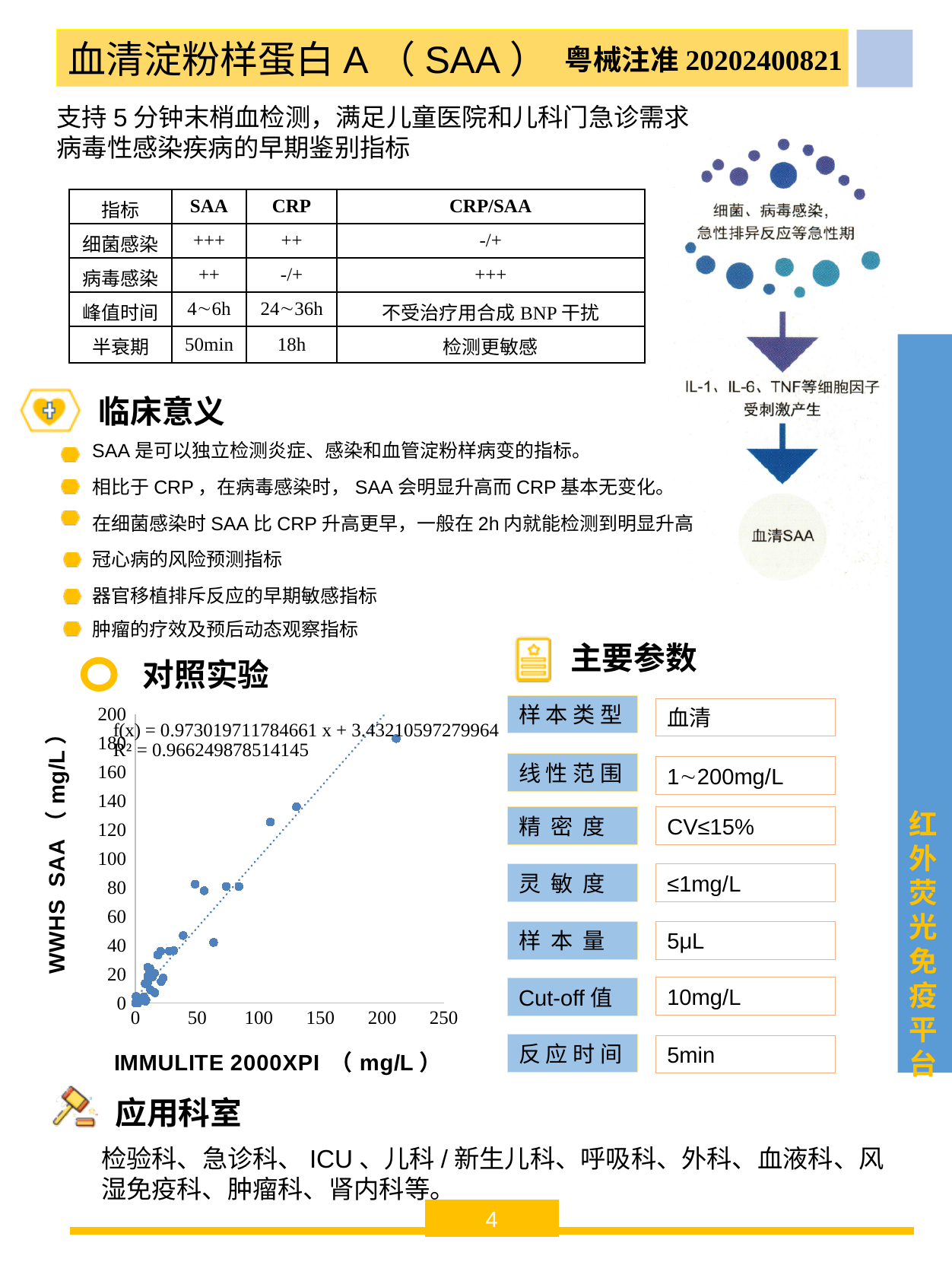
What is the intercept of the fitted line f(x) printed on the scatter chart? 3.43210597279964 Do the points in the scatter chart generally rise or fall as the x value increases? rise What is the label of the x axis of the scatter chart? IMMULITE 2000XPI （mg/L） Is the y value of the point near x = 60 in the scatter chart greater or less than 60? less What is the label of the y axis of the scatter chart? WWHS SAA（mg/L） Is the y value of the point near x = 110 in the scatter chart greater or less than 100? greater What is the maximum value shown on the x axis of the scatter chart? 250 What is the R² value printed on the scatter chart? 0.966249878514145 What kind of chart is shown under the heading 对照实验? scatter chart Is the x value of the rightmost point in the scatter chart greater or less than 150? greater What is the slope of the fitted line f(x) printed on the scatter chart? 0.973019711784661